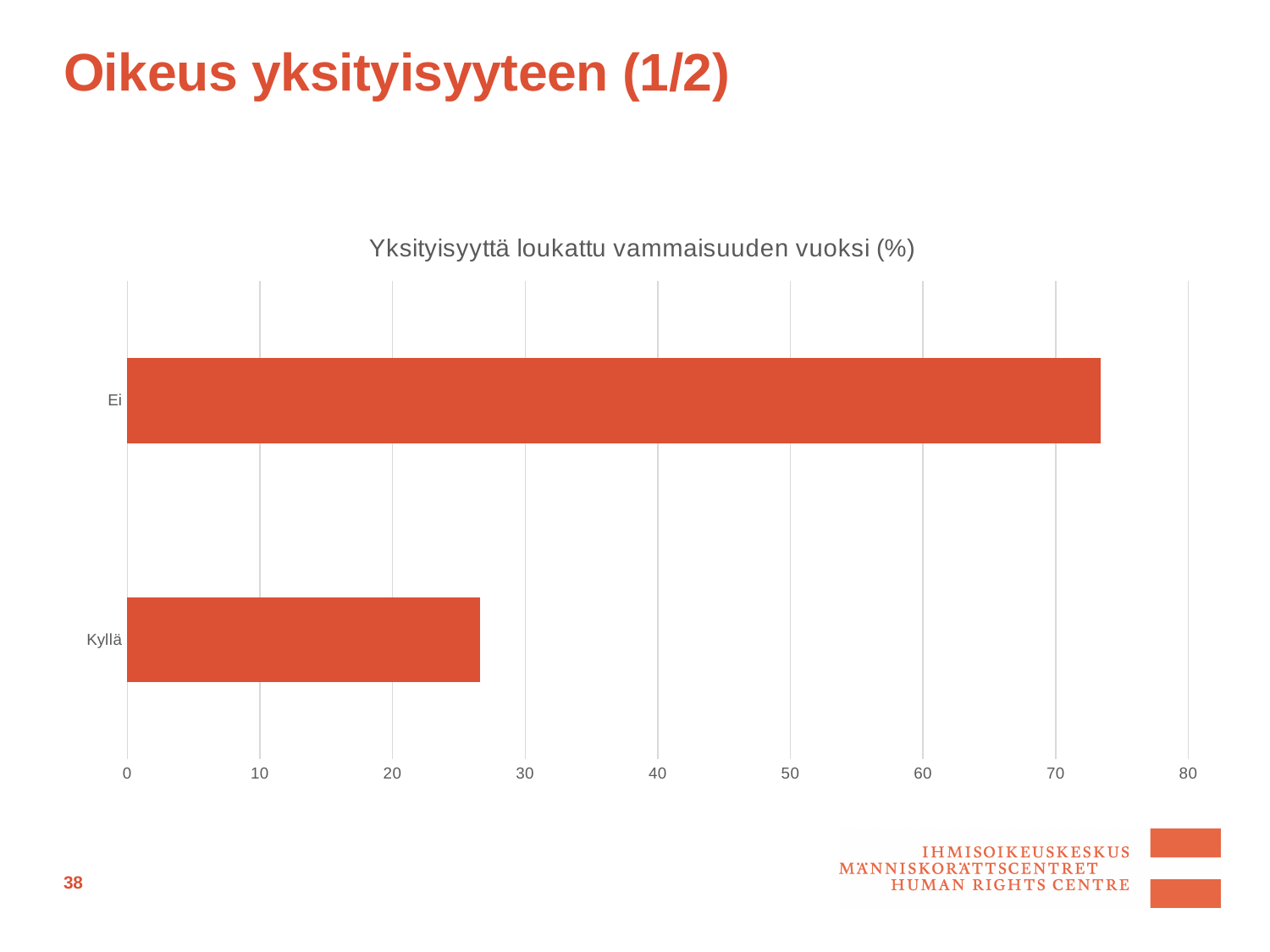
Is the value for Kyllä greater or less than 20? greater Which category has the lowest value in the chart? Kyllä What is the highest value shown on the horizontal axis of the chart? 80 How many categories are plotted in the chart? 2 Is the value for Ei greater or less than 70? greater Which is larger, the value for Ei or the value for Kyllä? Ei What kind of chart is shown on the slide? bar chart Is the value for Ei greater or less than 80? less Which category has the highest value in the chart? Ei What is the title of the chart? Yksityisyyttä loukattu vammaisuuden vuoksi (%)